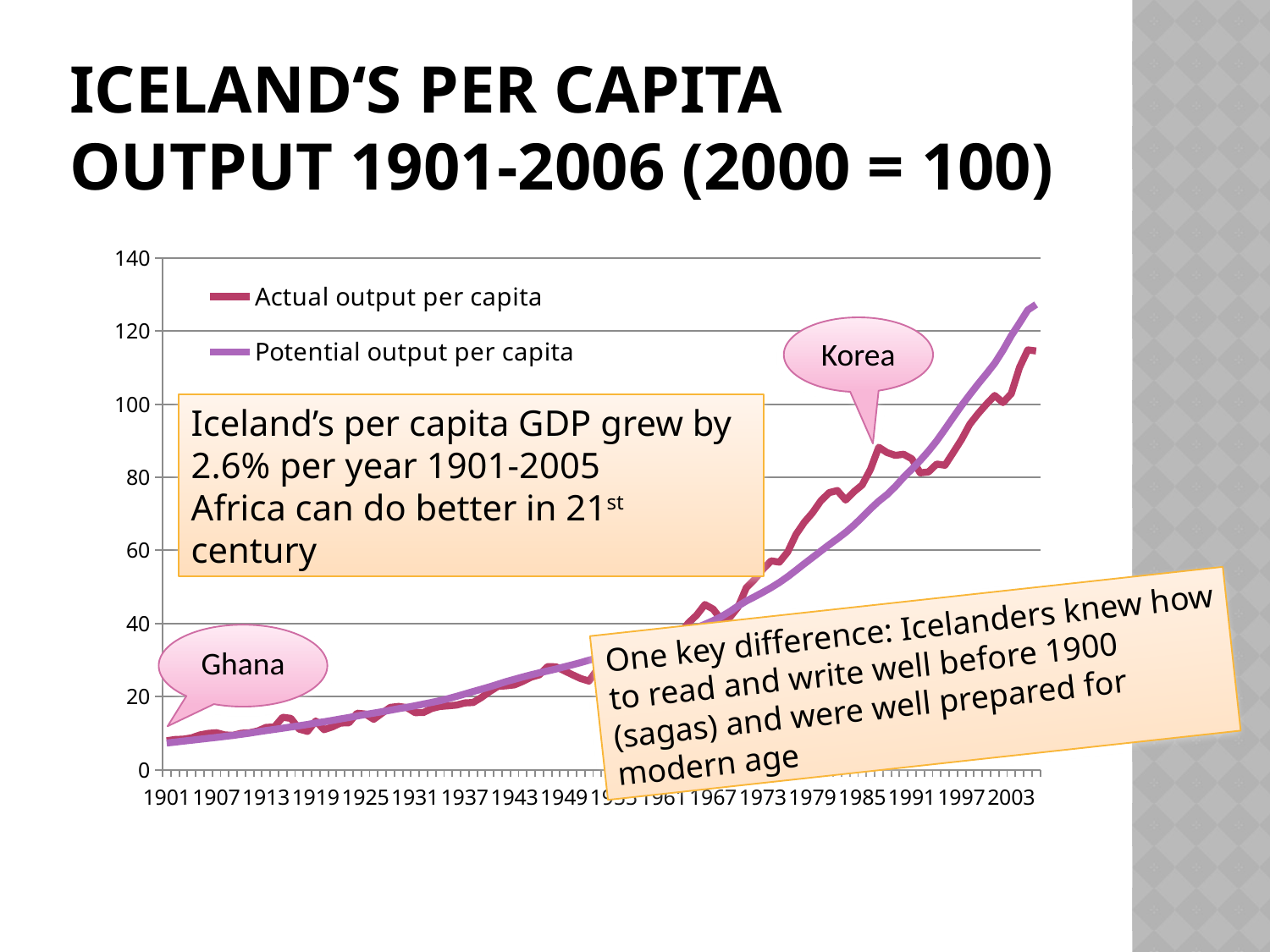
What kind of chart is shown on the slide? line chart What are the two series named in the legend? Actual output per capita; Potential output per capita What is the title of the slide's chart? Iceland's per capita output 1901-2006 (2000 = 100) Is the value for Actual output per capita in 1949 greater or less than 40? less How many series does the legend list? 2 Which series is higher around 1985, Actual output per capita or Potential output per capita? Actual output per capita How many year labels are shown on the x axis? 18 Is the value for Actual output per capita in 1901 greater or less than 20? less Is the value for Potential output per capita in 1973 greater or less than 60? less Do the values of Actual output per capita rise or fall from 1901 to 2003 overall? rise Which series is higher at the right end of the chart (around 2003), Actual output per capita or Potential output per capita? Potential output per capita